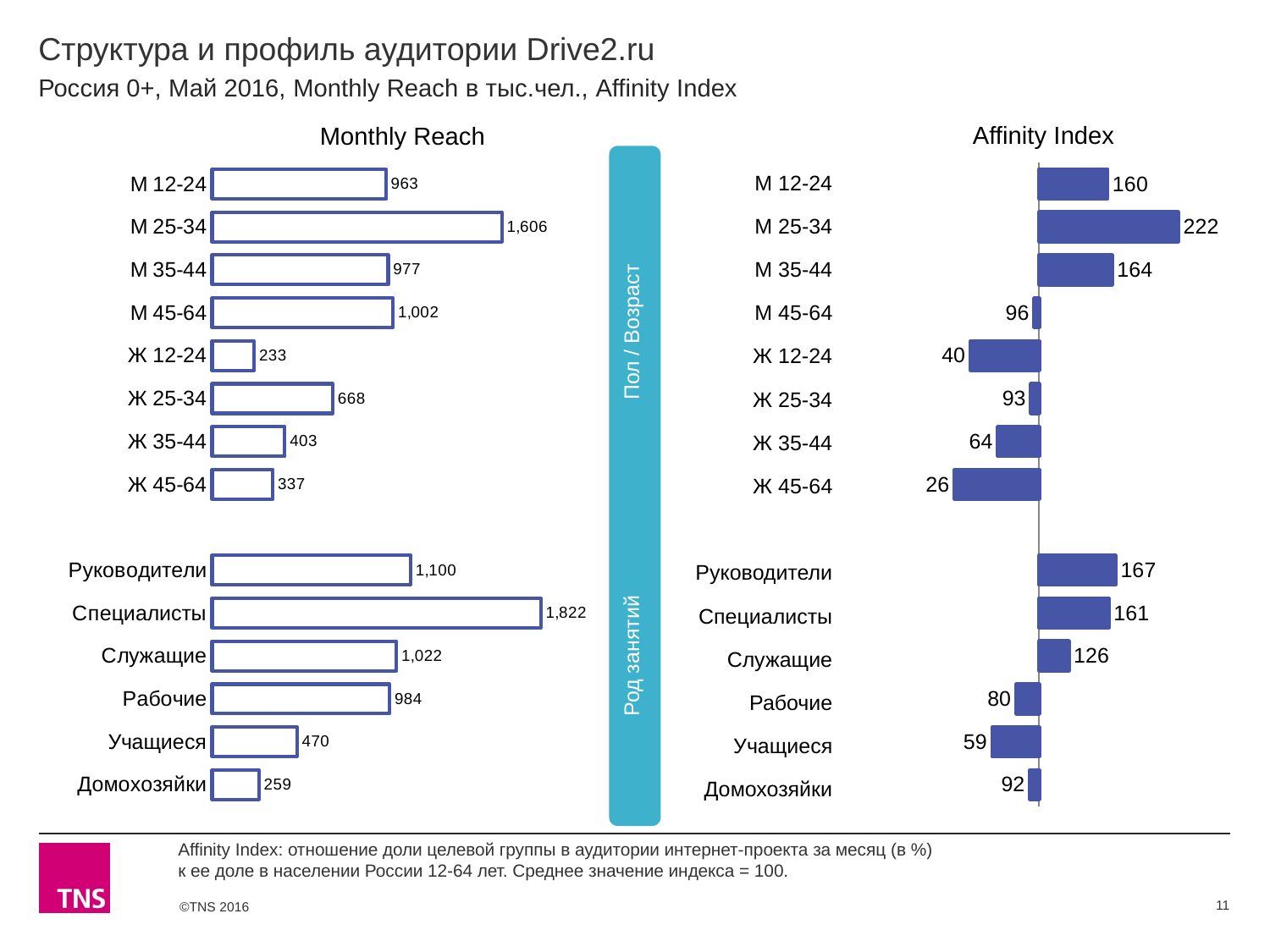
In the Monthly Reach chart, what is the difference between the values for Специалисты and Руководители? 722 In the Affinity Index chart, what is the difference between the values for М 25-34 and М 12-24? 62 In the Monthly Reach chart, what is the value for М 25-34? 1,606 In the Monthly Reach chart, what is the value for Домохозяйки? 259 In the Affinity Index chart, which is larger, the value for Рабочие or the value for Учащиеся? Рабочие What kind of chart is the Affinity Index chart? bar chart In the Affinity Index chart, which category has the lowest value? Ж 45-64 In the Monthly Reach chart, which is larger, the value for Ж 25-34 or the value for Ж 35-44? Ж 25-34 In the Affinity Index chart, what is the value for Ж 45-64? 26 How many categories are plotted in the Monthly Reach chart? 14 In the Affinity Index chart, which category has the highest value? М 25-34 In the Monthly Reach chart, which category has the highest value? Специалисты